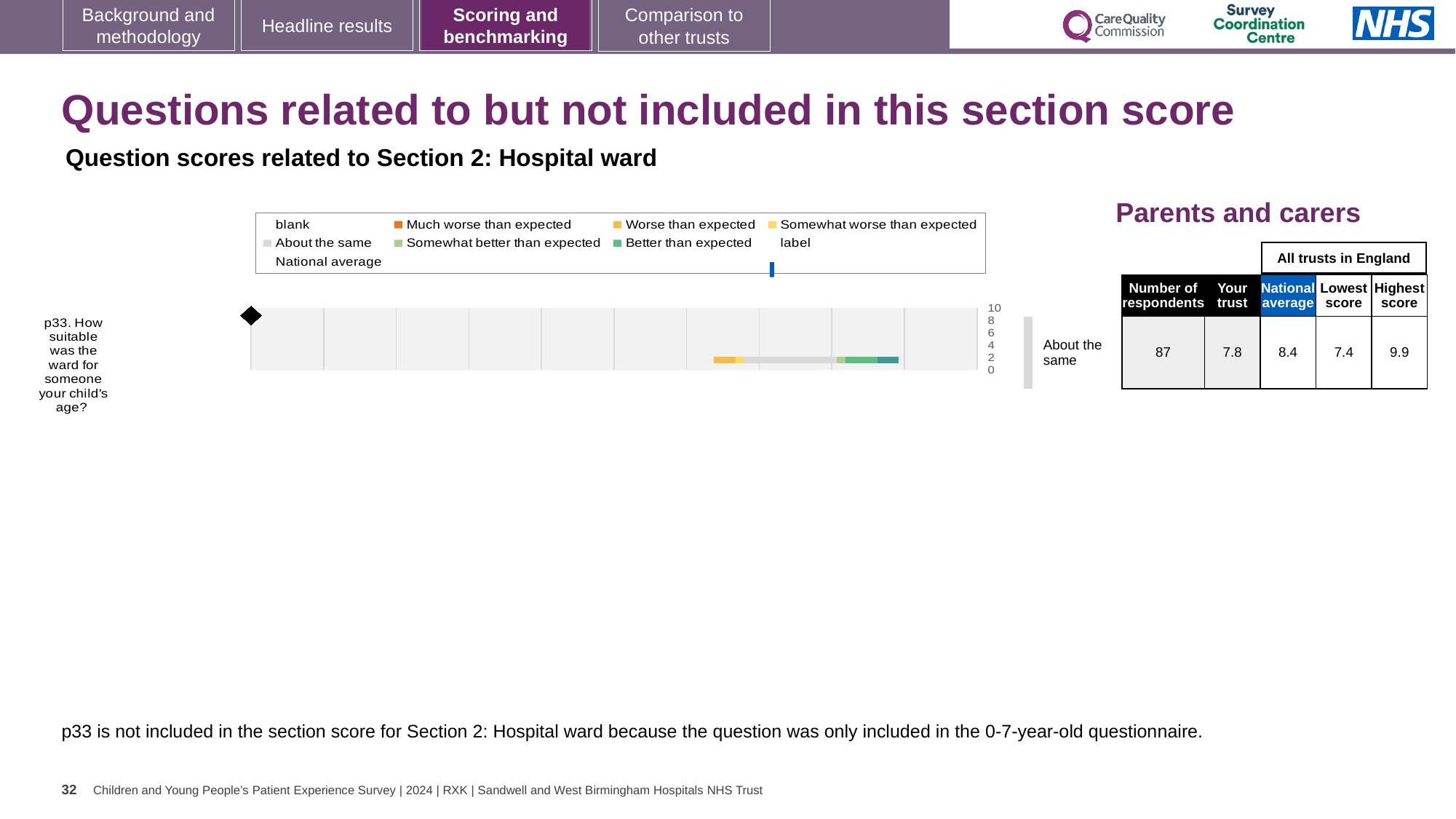
What benchmark category is shown next to the chart for p33? About the same What is the subtitle of the chart on this slide? Question scores related to Section 2: Hospital ward What is the difference between the highest and lowest trust scores for p33? 2.5 How many questions are plotted in the chart? 1 What is the national average score for p33? 8.4 How many respondents answered question p33? 87 What is the difference between the national average and the trust's score for p33? 0.6 What is the highest score among all trusts in England for p33? 9.9 Which is larger for p33: the trust's score or the national average? National average What is the 'Your trust' score for p33 in the table? 7.8 What kind of chart is used to show the score for question p33? bar chart What is the lowest score among all trusts in England for p33? 7.4